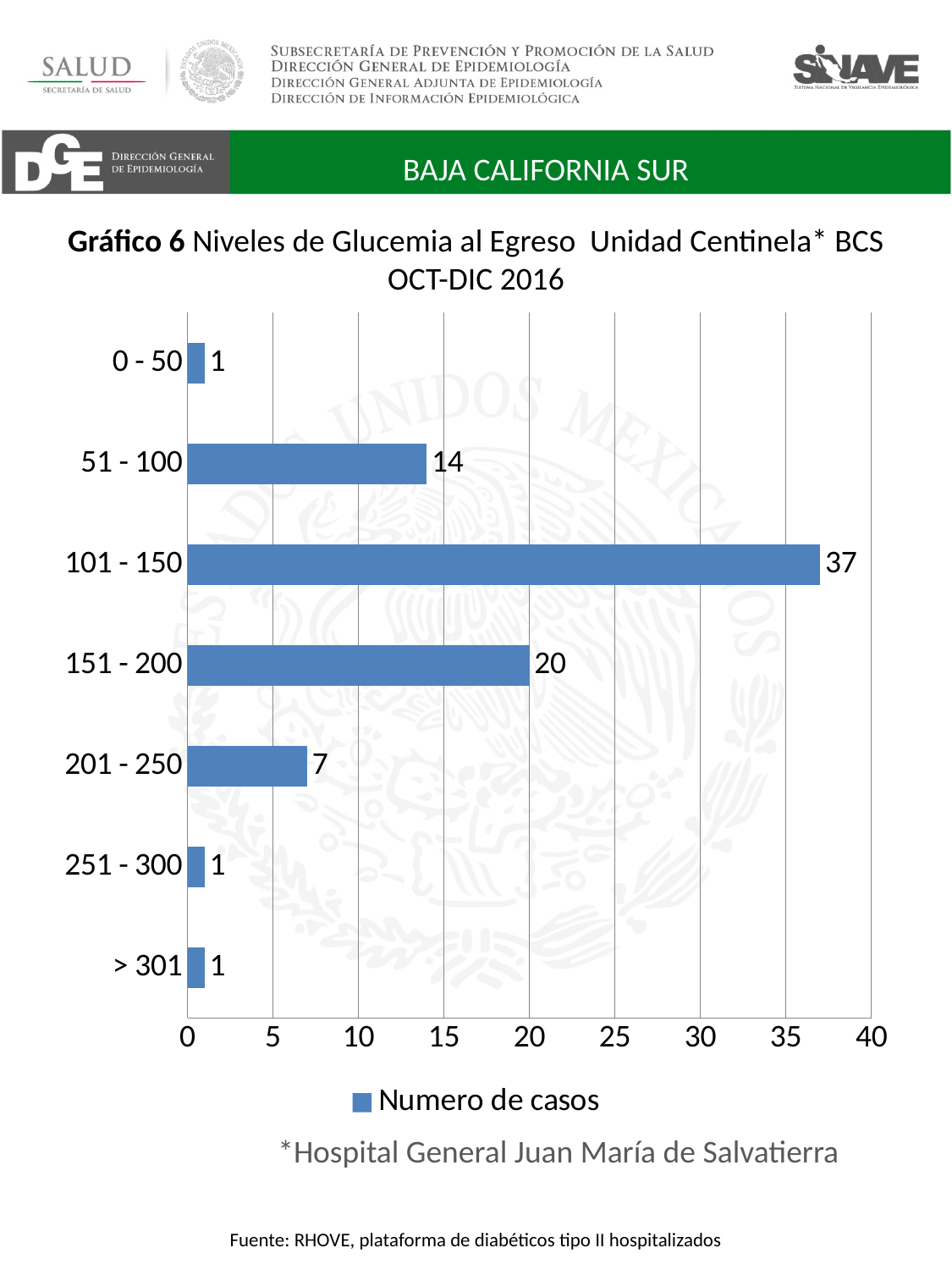
Which has more cases, the 51 - 100 category or the 151 - 200 category? 151 - 200 How many categories have exactly 1 case? 3 What is the name of the series shown in the legend? Numero de casos Which glucose level category has the highest number of cases? 101 - 150 How many glucose level categories are shown on the chart? 7 What is the number of cases for the 201 - 250 category? 7 What is the total number of cases across all categories? 81 What is the number of cases for the 101 - 150 glucose level category? 37 What is the difference in number of cases between the 101 - 150 and 151 - 200 categories? 17 How many series does the legend list? 1 What kind of chart is shown on the slide? Bar chart What is the number of cases for the 51 - 100 category? 14